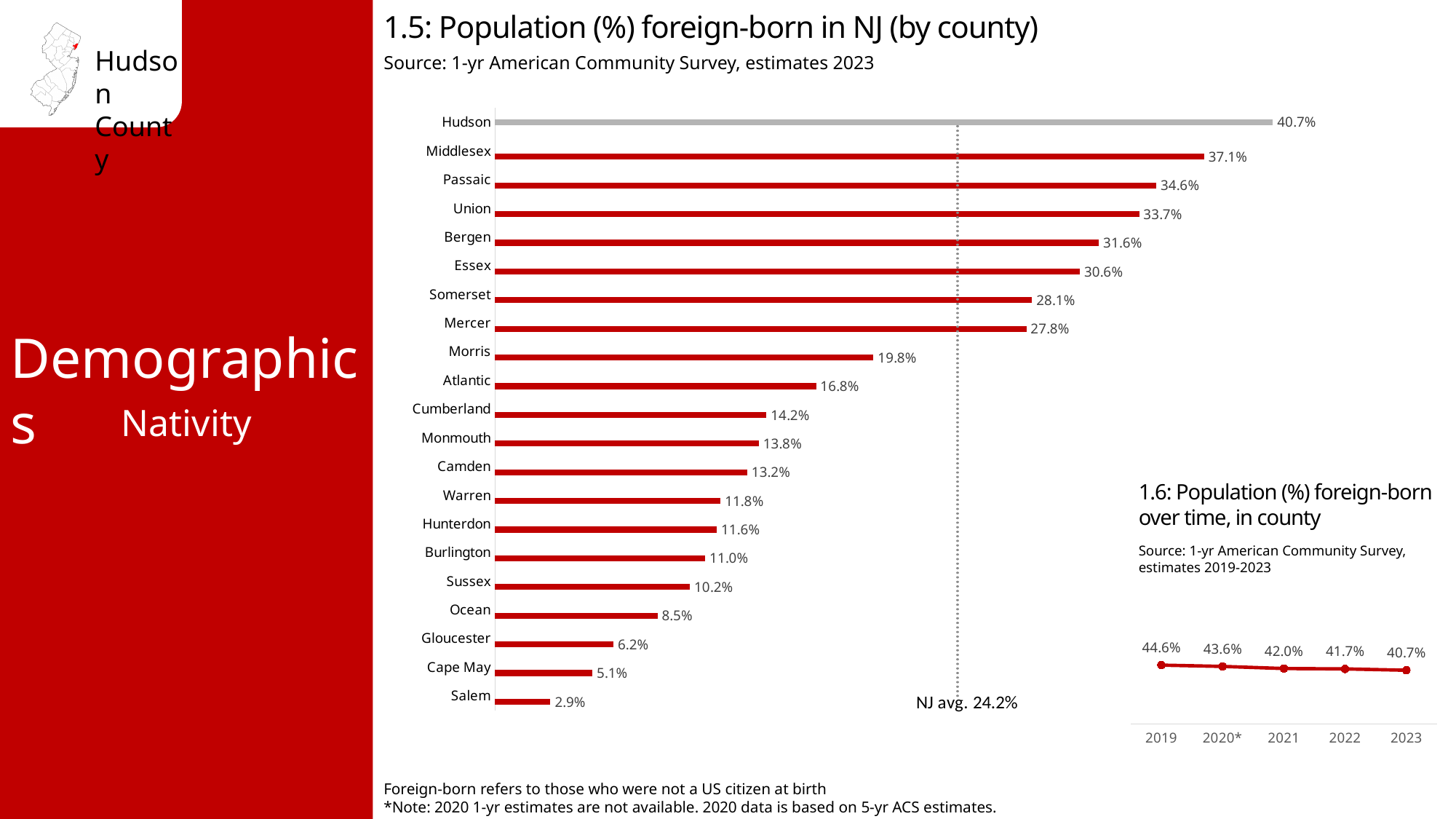
In chart 1.5 (Population (%) foreign-born in NJ by county), what is the value for Bergen? 31.6% In chart 1.5 (Population (%) foreign-born in NJ by county), how many counties are plotted? 21 In chart 1.6 (Population (%) foreign-born over time, in county), what is the difference between 2019 and 2023? 3.9% In chart 1.6 (Population (%) foreign-born over time, in county), what is the value for 2019? 44.6% What kind of chart is chart 1.5 (Population (%) foreign-born in NJ by county)? bar chart In chart 1.5 (Population (%) foreign-born in NJ by county), what is the difference between Hudson and Middlesex? 3.6% In chart 1.5 (Population (%) foreign-born in NJ by county), what NJ average is marked by the dotted line? 24.2% In chart 1.6 (Population (%) foreign-born over time, in county), do the values rise or fall from 2019 to 2023? fall In chart 1.5 (Population (%) foreign-born in NJ by county), which is larger, Morris or Atlantic? Morris In chart 1.5 (Population (%) foreign-born in NJ by county), what is the value for Hudson? 40.7% In chart 1.5 (Population (%) foreign-born in NJ by county), which county has the highest value? Hudson In chart 1.5 (Population (%) foreign-born in NJ by county), which county has the lowest value? Salem